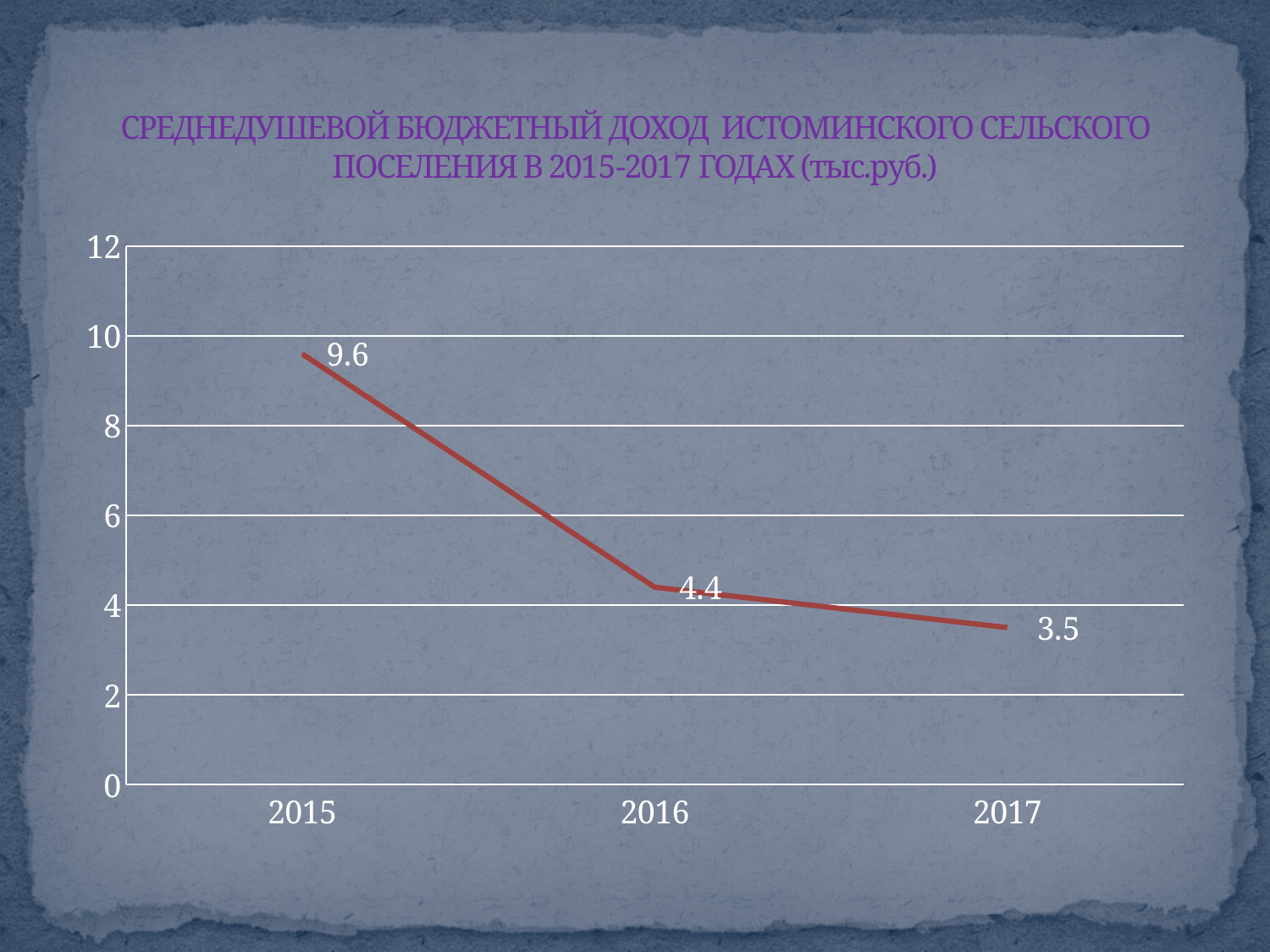
Which year has the lowest value? 2017 What is the value for 2015? 9.6 How many years are plotted on the chart? 3 What kind of chart is shown on the slide? line chart What is the difference between the values for 2016 and 2017? 0.9 Do the values rise or fall from 2015 to 2017? fall Which year has the highest value? 2015 Which is larger, the value for 2015 or the value for 2017? 2015 Is the value for 2015 greater or less than 8? greater What is the value for 2017? 3.5 What is the value for 2016? 4.4 What is the difference between the values for 2015 and 2016? 5.2